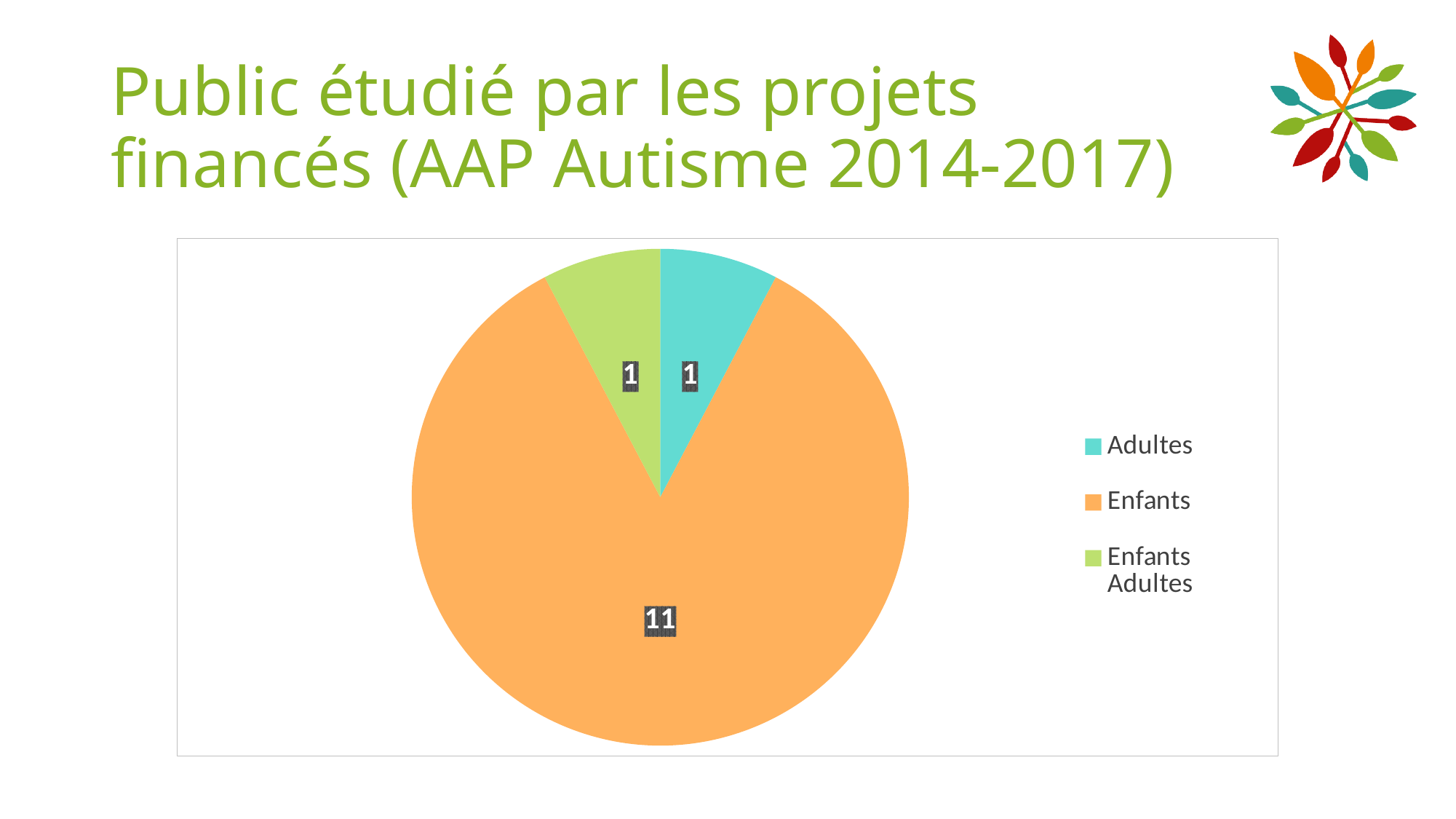
What is the total of all the slices in the pie? 13 Which category has the largest slice of the pie? Enfants Which is larger, the value for Enfants or the value for Adultes? Enfants What is the title of the slide containing the chart? Public étudié par les projets financés (AAP Autisme 2014-2017) What kind of chart is shown on the slide? Pie chart What is the difference between the value for Enfants and the value for Adultes? 10 What colour is the Enfants slice? Orange What is the value for Adultes? 1 What is the value for Enfants? 11 How many slices does the pie chart have? 3 How many entries does the legend list? 3 What is the value for Enfants Adultes? 1